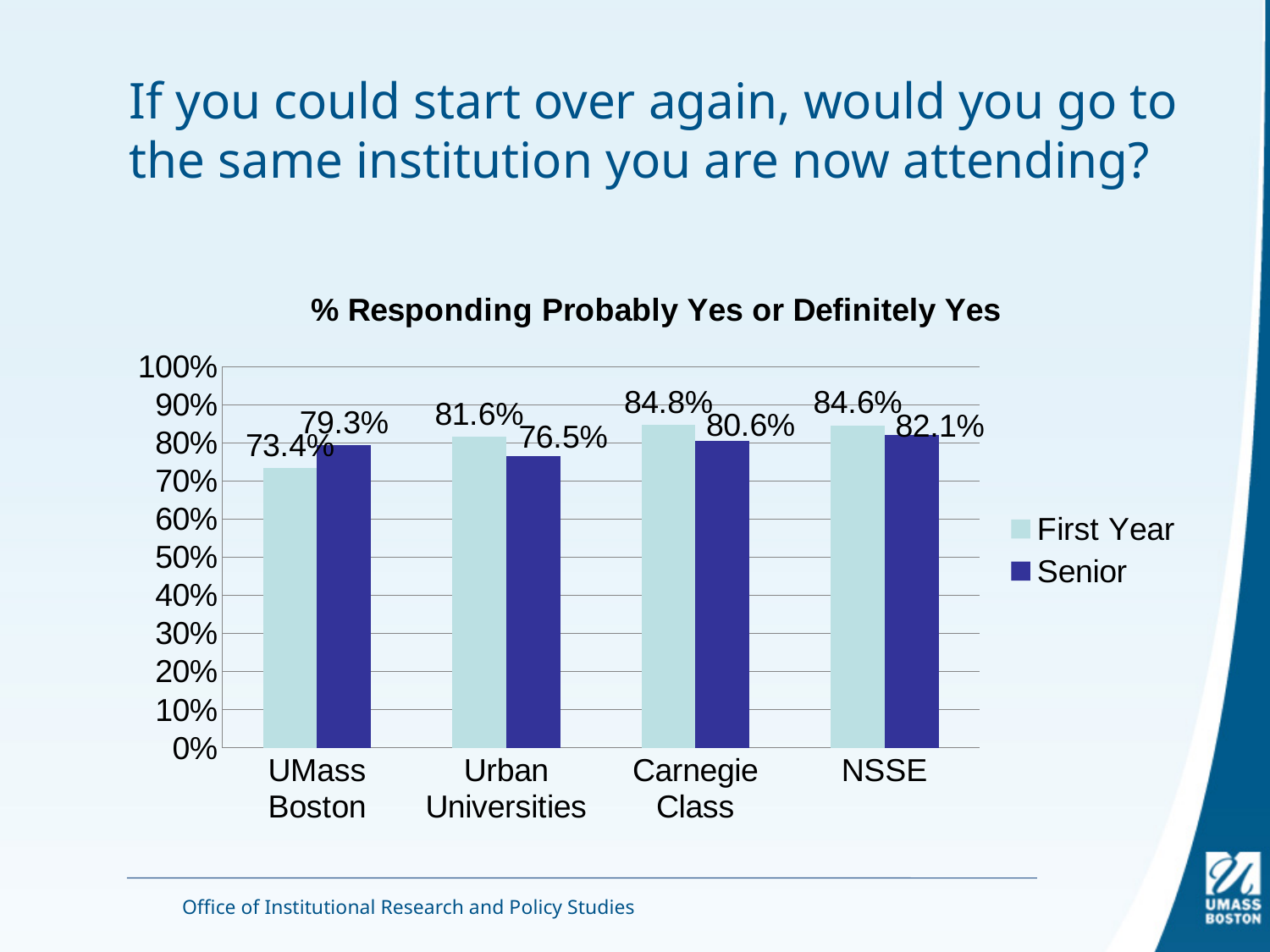
What is the Senior value for NSSE? 82.1% What is the title of the chart? % Responding Probably Yes or Definitely Yes How many series does the legend list? 2 What is the Senior value for Urban Universities? 76.5% What is the difference between the Senior and First Year values for UMass Boston? 5.9% Which category has the lowest Senior value? Urban Universities What is the First Year value for Carnegie Class? 84.8% How many categories are shown on the x axis? 4 Which category has the highest First Year value? Carnegie Class Which is larger for Urban Universities, the First Year value or the Senior value? First Year What kind of chart is shown on the slide? Bar chart What is the First Year value for UMass Boston? 73.4%